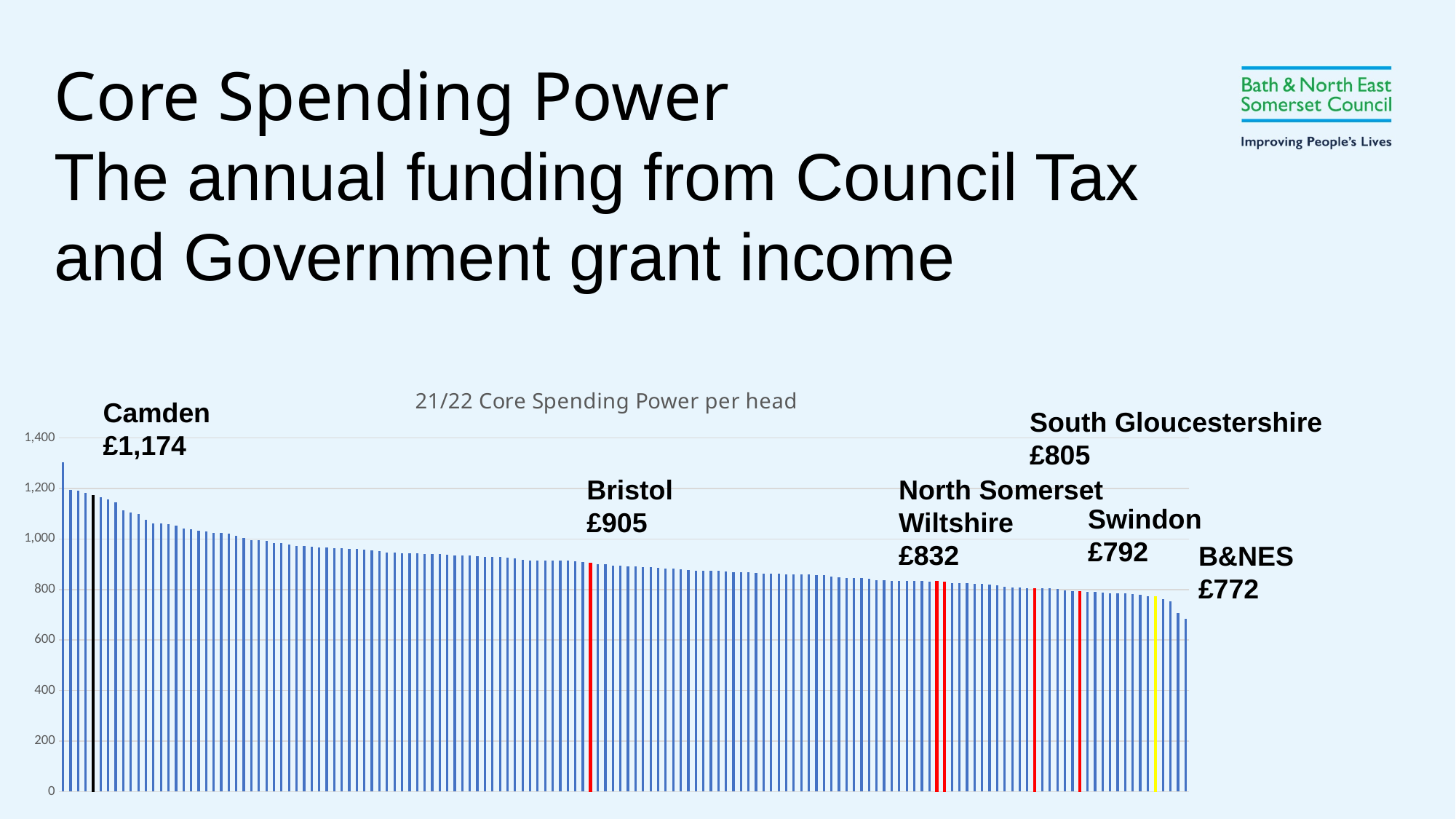
Is the value of the leftmost (tallest) bar greater or less than 1,200? greater Which has the higher Core Spending Power per head, Swindon or South Gloucestershire? South Gloucestershire What is the Core Spending Power per head for South Gloucestershire? £805 Do the bar values rise or fall from left to right across the chart? fall What is the Core Spending Power per head for Bristol? £905 What is the title of the chart? 21/22 Core Spending Power per head What is the Core Spending Power per head for B&NES? £772 What is the difference between Bristol's and B&NES's Core Spending Power per head? £133 What is the Core Spending Power per head for Camden? £1,174 What is the Core Spending Power per head for Swindon? £792 What kind of chart is shown on the slide? bar chart How much higher is Camden's Core Spending Power per head than B&NES's? £402